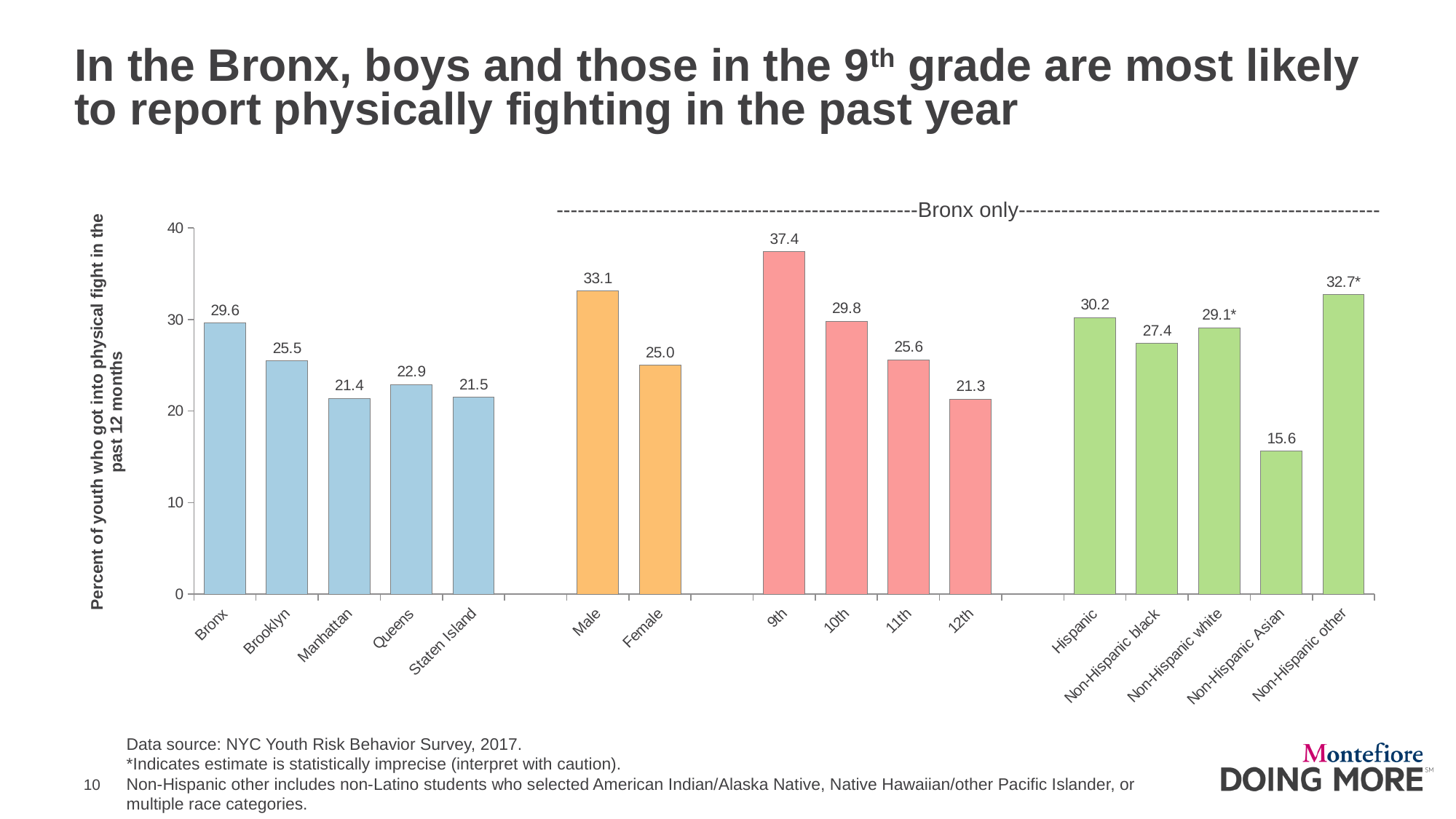
What kind of chart is shown on the slide? Bar chart Which is larger, the value for Bronx or the value for Brooklyn? Bronx What is the value for Male? 33.1 How many bars are shown on the chart? 16 Is the value for Hispanic greater or less than 30? greater Which category has the lowest value on the chart? Non-Hispanic Asian What is the value for Non-Hispanic Asian? 15.6 Do the values rise or fall from 9th grade to 12th grade? Fall Which category has the highest value on the chart? 9th What is the difference between the values for Male and Female? 8.1 What is the value for Bronx? 29.6 What is the value for 12th grade? 21.3